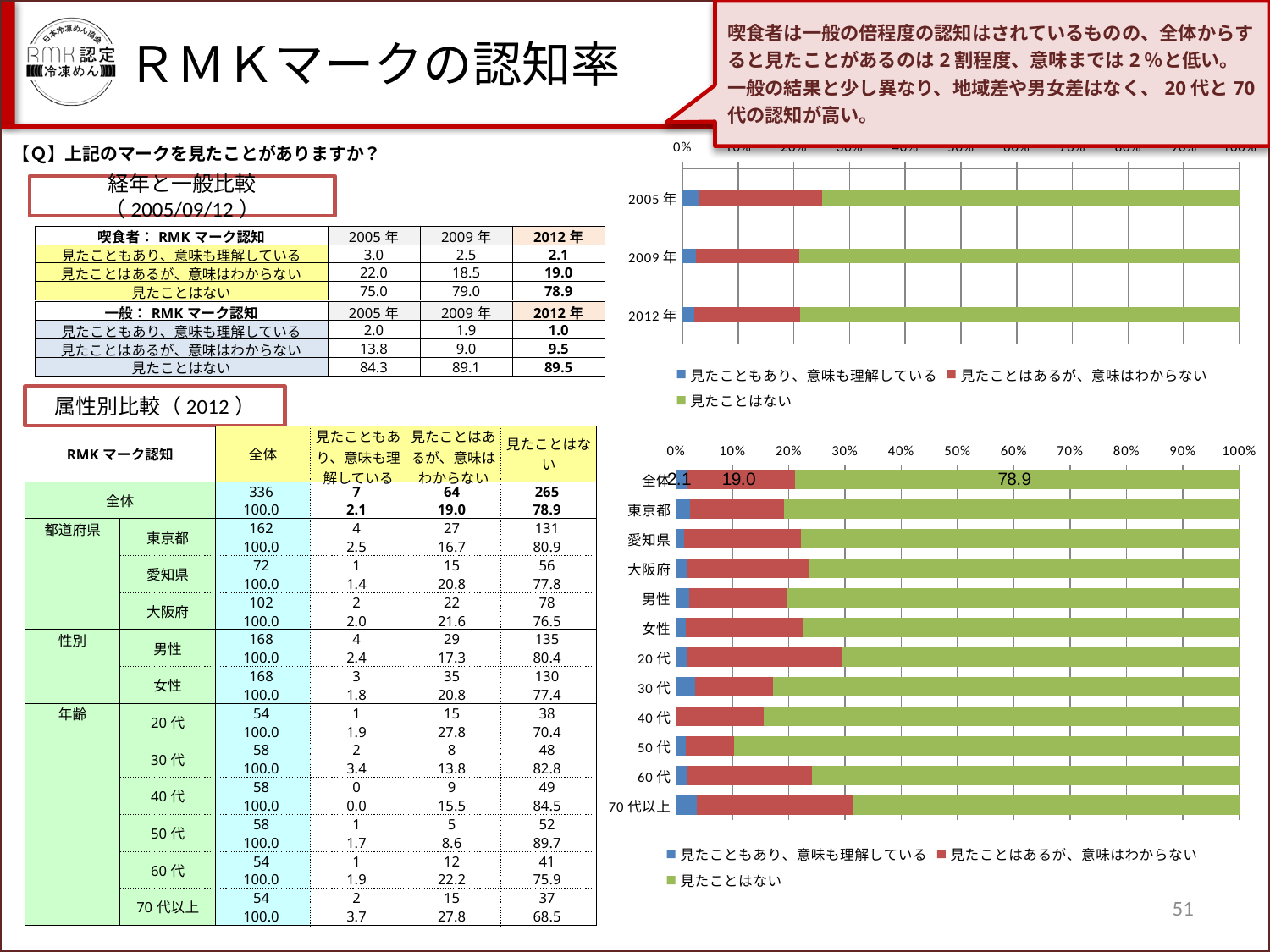
In the bottom-right chart, what is the total of the 全体 stacked bar? 100.0 In the bottom-right chart, which category has the highest value for 見たことはない? 50代 In the top-right chart, is the 見たことはない value for 2012年 greater or less than 70%? greater What kind of chart is the top-right chart? Stacked bar chart In the bottom-right chart, what is the value for 見たこともあり、意味も理解している in the 全体 bar? 2.1 In the bottom-right chart, what is the value for 見たことはあるが、意味はわからない in the 全体 bar? 19.0 In the bottom-right chart, what is the difference between the 見たことはない and 見たことはあるが、意味はわからない values in the 全体 bar? 59.9 How many series does the legend of the top-right chart list? 3 In the bottom-right chart, which has the larger 見たことはない value, 50代 or 70代以上? 50代 In the bottom-right chart, what is the value for 見たことはない in the 全体 bar? 78.9 In the bottom-right chart, is the 見たことはない value for 70代以上 greater or less than 70%? less How many categories are shown in the bottom-right chart? 12